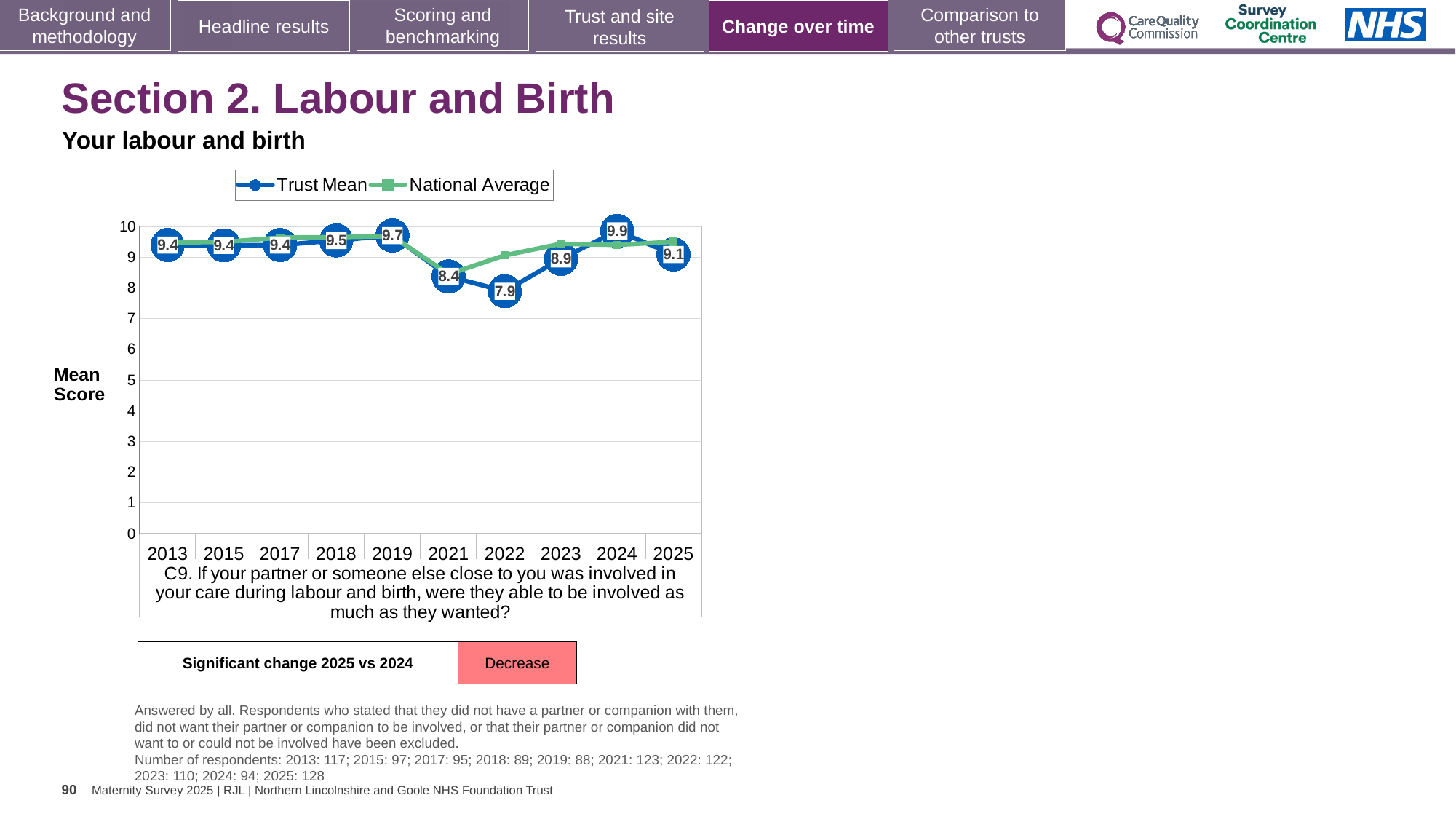
What is the Trust Mean for 2025? 9.1 How many series does the legend list? 2 In which year is the Trust Mean lowest? 2022 How many years are shown on the x axis? 10 What kind of chart is shown? Line chart Which is larger, the Trust Mean in 2021 or in 2023? 2023 What is the difference between the Trust Mean in 2024 and in 2025? 0.8 In which year is the Trust Mean highest? 2024 What is the Trust Mean for 2022? 7.9 What is the Trust Mean for 2019? 9.7 What is the Trust Mean for 2024? 9.9